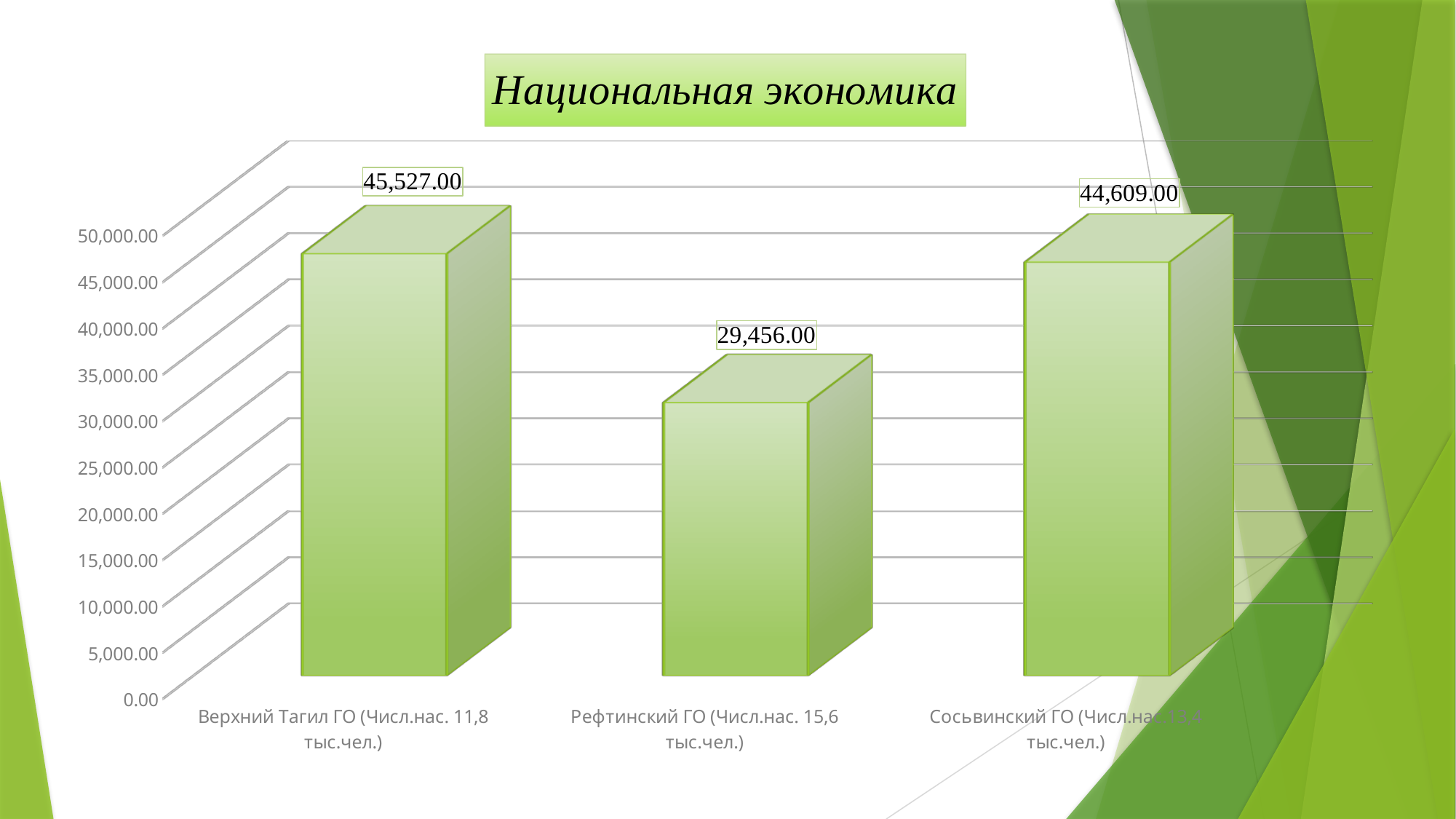
What is the value for Рефтинский ГО? 29,456.00 What is the difference between the values for Верхний Тагил ГО and Рефтинский ГО? 16,071.00 What is the value for Верхний Тагил ГО? 45,527.00 What kind of chart is shown on the slide? bar chart Which category has the highest value? Верхний Тагил ГО Is the value for Рефтинский ГО greater or less than 30,000.00? less Which is larger, the value for Сосьвинский ГО or the value for Рефтинский ГО? Сосьвинский ГО What is the title of the chart? Национальная экономика Which category has the lowest value? Рефтинский ГО What is the value for Сосьвинский ГО? 44,609.00 What is the difference between the values for Верхний Тагил ГО and Сосьвинский ГО? 918.00 How many categories are shown in the chart? 3